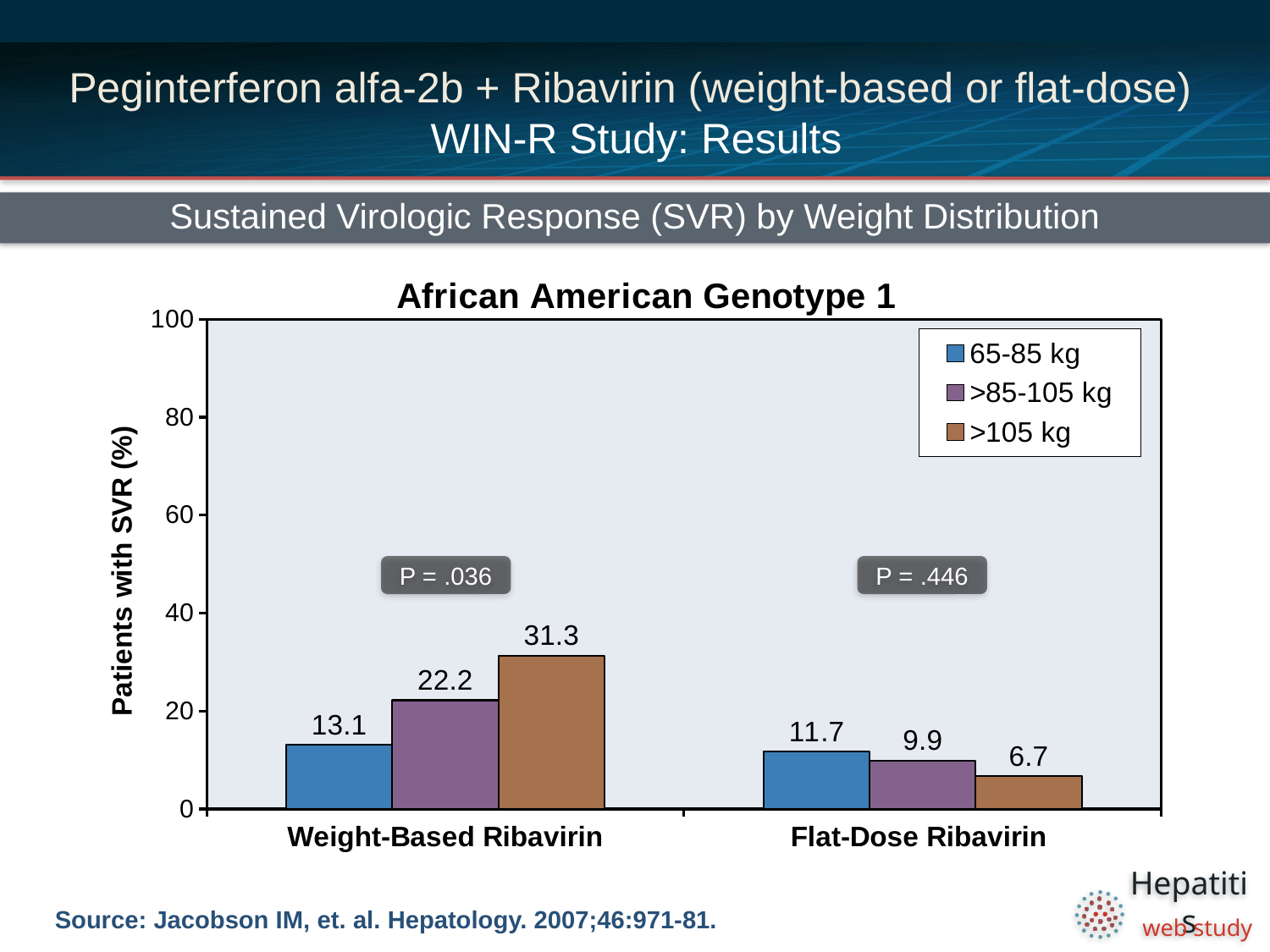
What is the SVR rate for the >105 kg group with Weight-Based Ribavirin? 31.3 How many series does the legend list? 3 What is the difference in SVR rate between the >105 kg group on Weight-Based Ribavirin and the >105 kg group on Flat-Dose Ribavirin? 24.6 What P value is shown for the Weight-Based Ribavirin group? P = .036 Which weight group has the highest SVR rate with Weight-Based Ribavirin? >105 kg Which weight group has the lowest SVR rate with Flat-Dose Ribavirin? >105 kg How many treatment categories are shown on the x axis? 2 What is the SVR rate for the 65-85 kg group with Flat-Dose Ribavirin? 11.7 Is the SVR rate for the >105 kg group with Weight-Based Ribavirin greater or less than 20? greater Which is larger: the SVR rate for the 65-85 kg group with Weight-Based Ribavirin or with Flat-Dose Ribavirin? Weight-Based Ribavirin What is the SVR rate for the >85-105 kg group with Weight-Based Ribavirin? 22.2 What kind of chart is shown on the slide? Bar chart